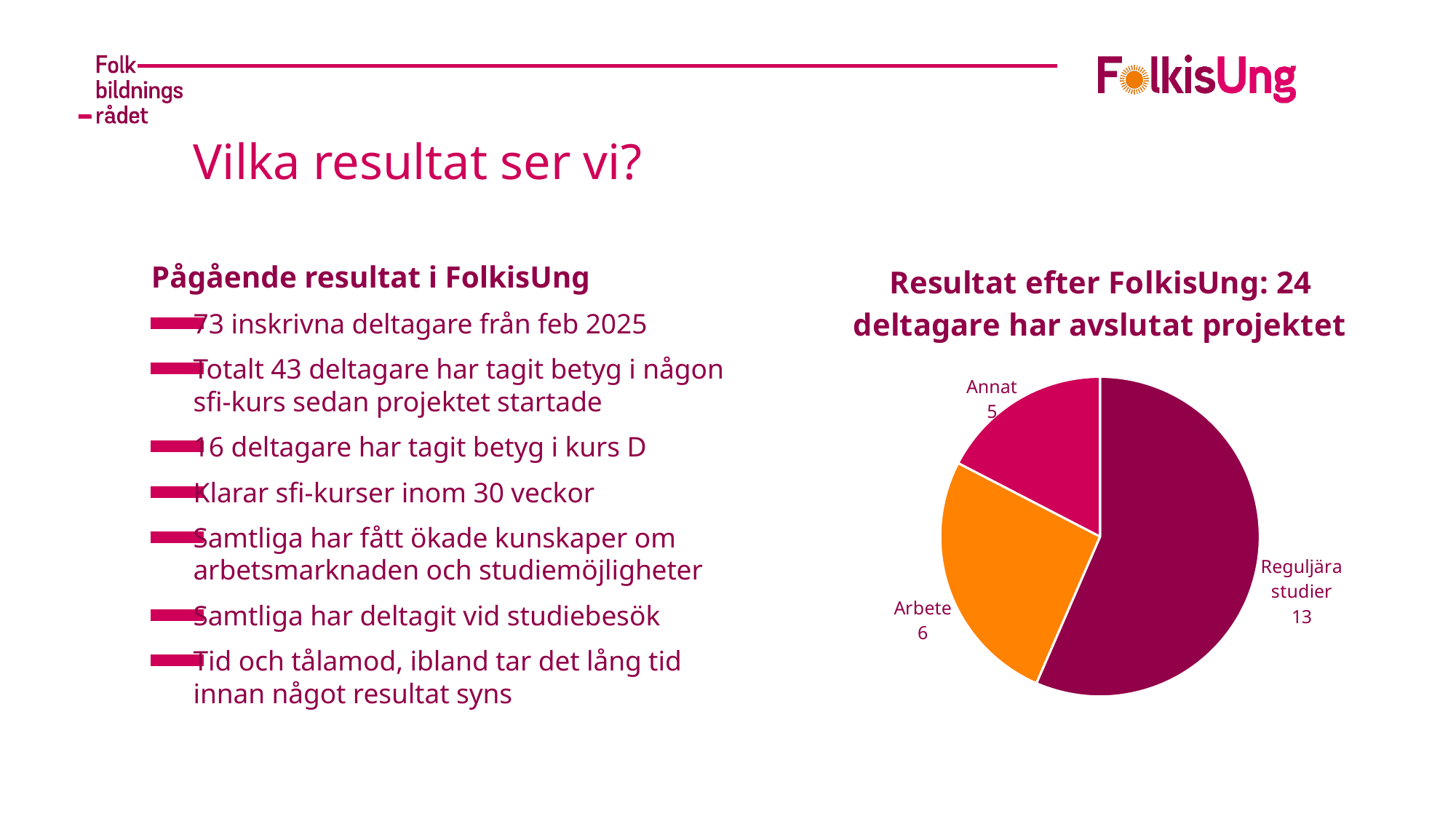
What is the value for Annat in the pie chart? 5 Which is larger, the value for Arbete or the value for Annat? Arbete Which category has the largest slice in the pie chart? Reguljära studier What is the value for Reguljära studier in the pie chart? 13 What is the difference between the values for Arbete and Annat? 1 What is the title of the pie chart? Resultat efter FolkisUng: 24 deltagare har avslutat projektet What share of the pie does Arbete represent? 25% What is the value for Arbete in the pie chart? 6 What kind of chart is shown on the slide? pie chart What is the difference between the values for Reguljära studier and Arbete? 7 Which category has the smallest slice in the pie chart? Annat How many categories does the pie chart show? 3